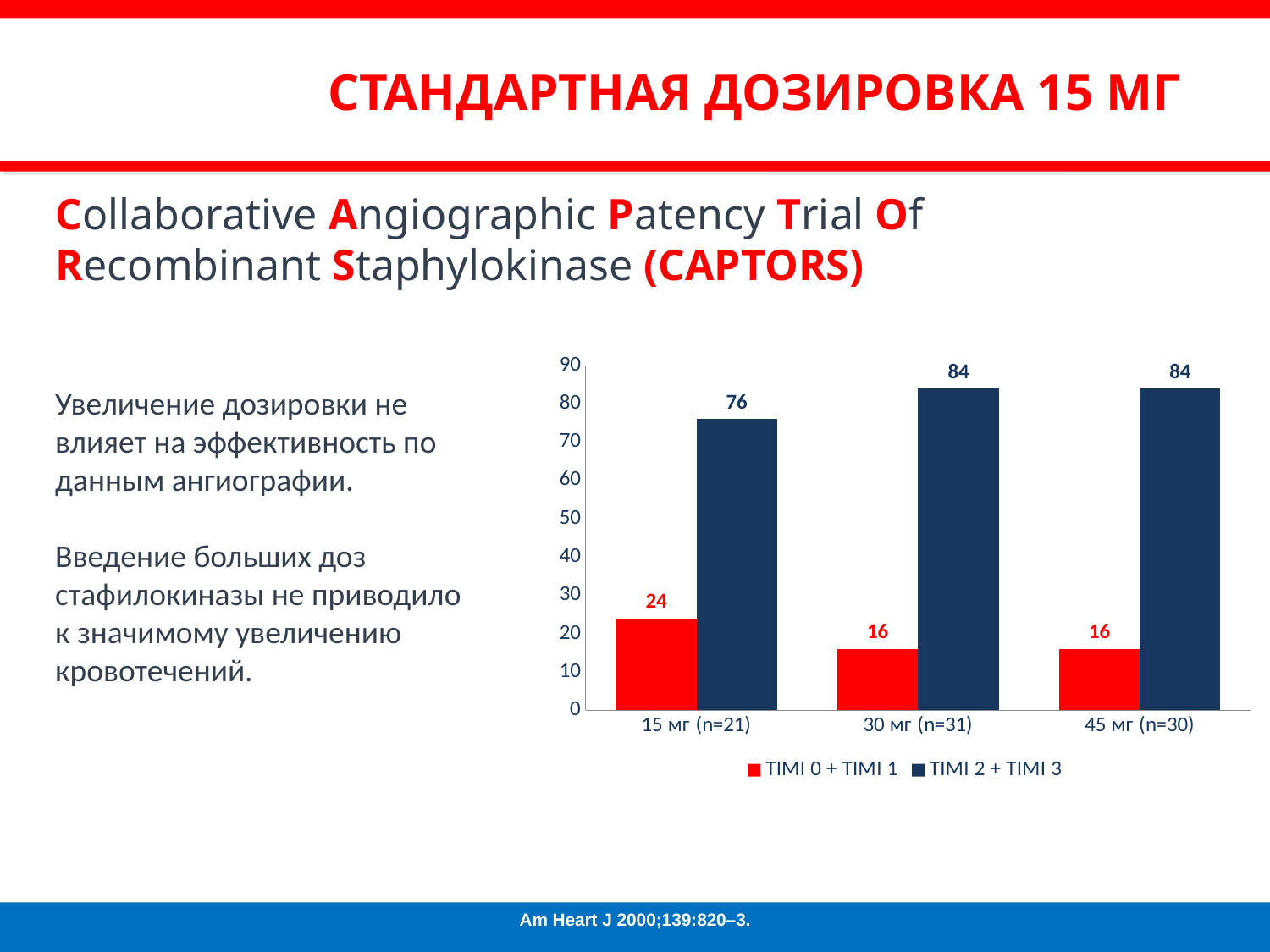
Which dose group has the highest TIMI 0 + TIMI 1 value? 15 мг (n=21) How many series does the legend list? 2 How many dose groups are shown on the x axis? 3 What kind of chart is shown on the slide? bar chart What is the value for TIMI 2 + TIMI 3 in the 15 мг (n=21) group? 76 What is the value for TIMI 0 + TIMI 1 in the 15 мг (n=21) group? 24 Is the TIMI 2 + TIMI 3 value for the 30 мг (n=31) group greater or less than 80? greater What is the value for TIMI 2 + TIMI 3 in the 45 мг (n=30) group? 84 Which is larger in the 15 мг (n=21) group: TIMI 0 + TIMI 1 or TIMI 2 + TIMI 3? TIMI 2 + TIMI 3 What is the difference between the TIMI 2 + TIMI 3 values for the 30 мг (n=31) and 15 мг (n=21) groups? 8 What is the value for TIMI 0 + TIMI 1 in the 30 мг (n=31) group? 16 Which dose group has the lowest TIMI 2 + TIMI 3 value? 15 мг (n=21)